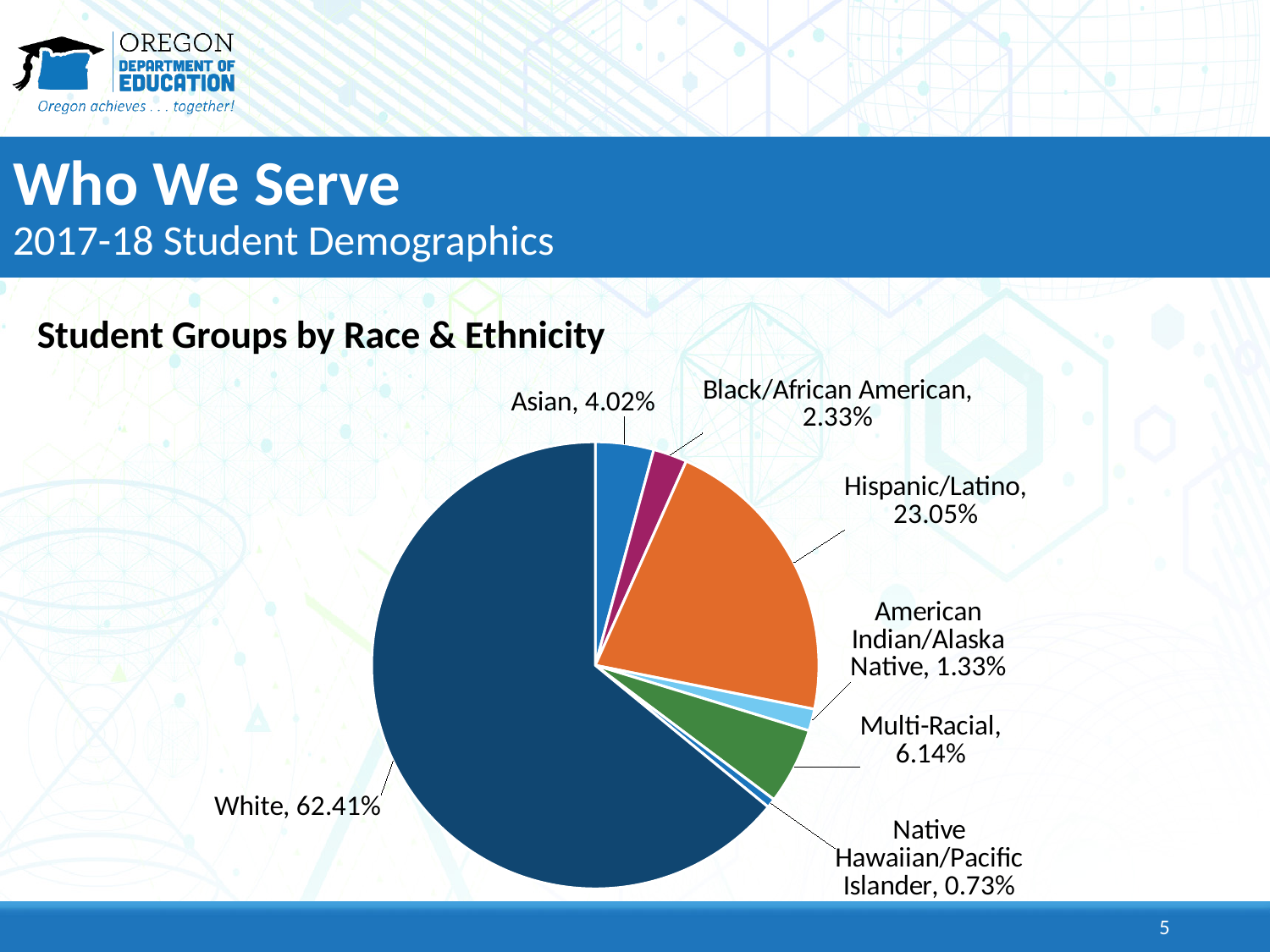
Which group has a larger share, Asian or Black/African American? Asian Which student group has the smallest share of the pie? Native Hawaiian/Pacific Islander Which student group has the largest share of the pie? White What share of students is Multi-Racial? 6.14% What share of students is Hispanic/Latino? 23.05% What share of students is White? 62.41% How many student groups are shown in the pie chart? 7 What is the title of the chart? Student Groups by Race & Ethnicity What kind of chart is shown on the slide? Pie chart What share of students is Native Hawaiian/Pacific Islander? 0.73% What is the difference in percentage points between the Asian share and the American Indian/Alaska Native share? 2.69 What is the difference in percentage points between the Hispanic/Latino share and the Multi-Racial share? 16.91